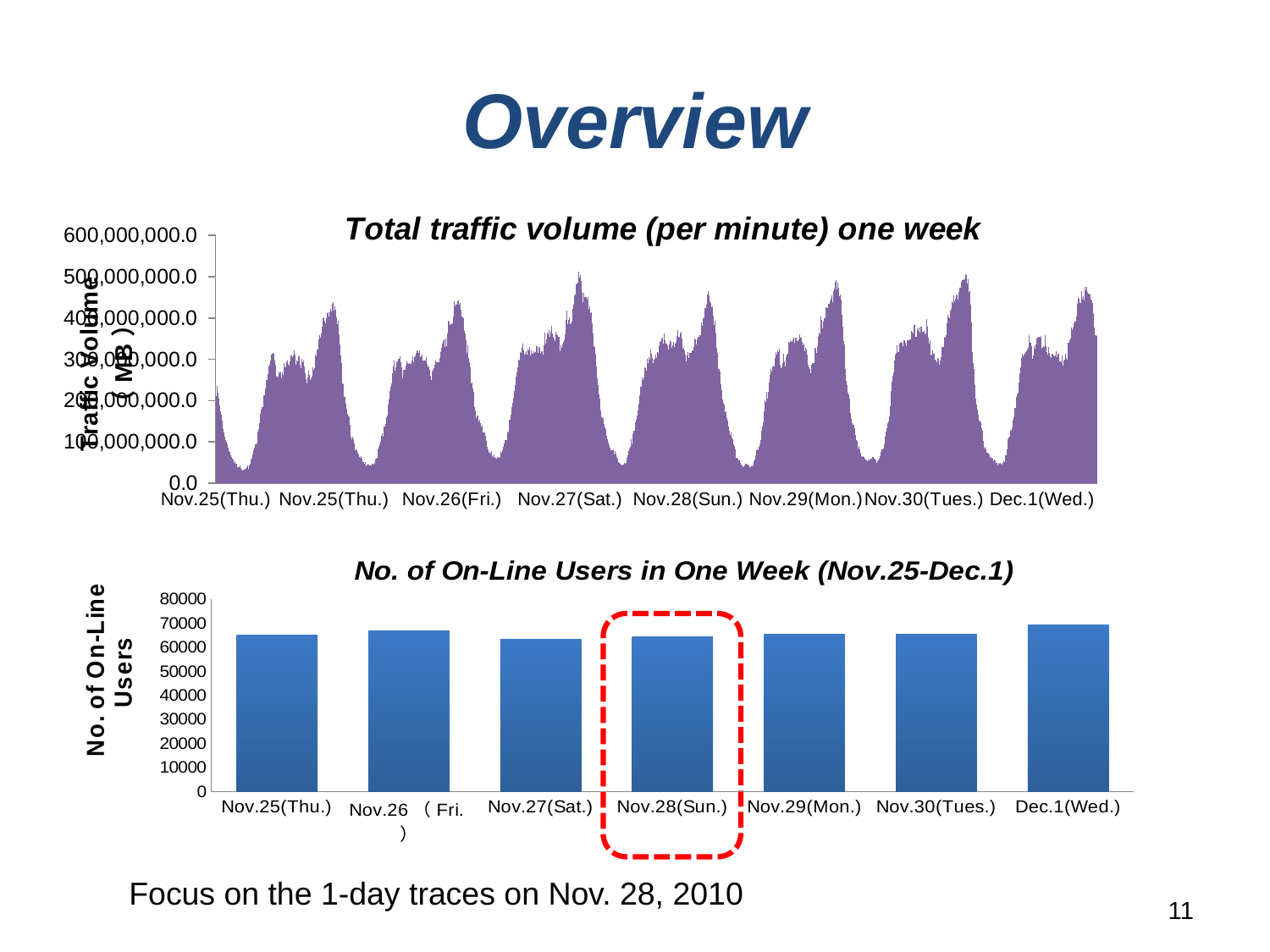
In the 'Total traffic volume (per minute) one week' chart, does the traffic volume follow a repeating daily pattern or a steady rise across the week? repeating daily pattern In the 'No. of On-Line Users in One Week' chart, is the value for Nov.28(Sun.) greater or less than 50000? greater In the 'Total traffic volume (per minute) one week' chart, is the highest peak greater or less than 600,000,000.0? less What is the y-axis label of the 'No. of On-Line Users in One Week' chart? No. of On-Line Users What kind of chart is the 'No. of On-Line Users in One Week (Nov.25-Dec.1)' chart? bar chart In the 'No. of On-Line Users in One Week' chart, which is larger, the value for Dec.1(Wed.) or the value for Nov.27(Sat.)? Dec.1(Wed.) In the 'No. of On-Line Users in One Week' chart, is the value for Nov.27(Sat.) greater or less than 70000? less In the 'No. of On-Line Users in One Week' chart, which day is highlighted with a red dashed box? Nov.28(Sun.) In the 'Total traffic volume (per minute) one week' chart, what is the highest value shown on the y axis? 600,000,000.0 How many bars (days) are shown in the 'No. of On-Line Users in One Week (Nov.25-Dec.1)' chart? 7 What is the title of the top chart on the slide? Total traffic volume (per minute) one week